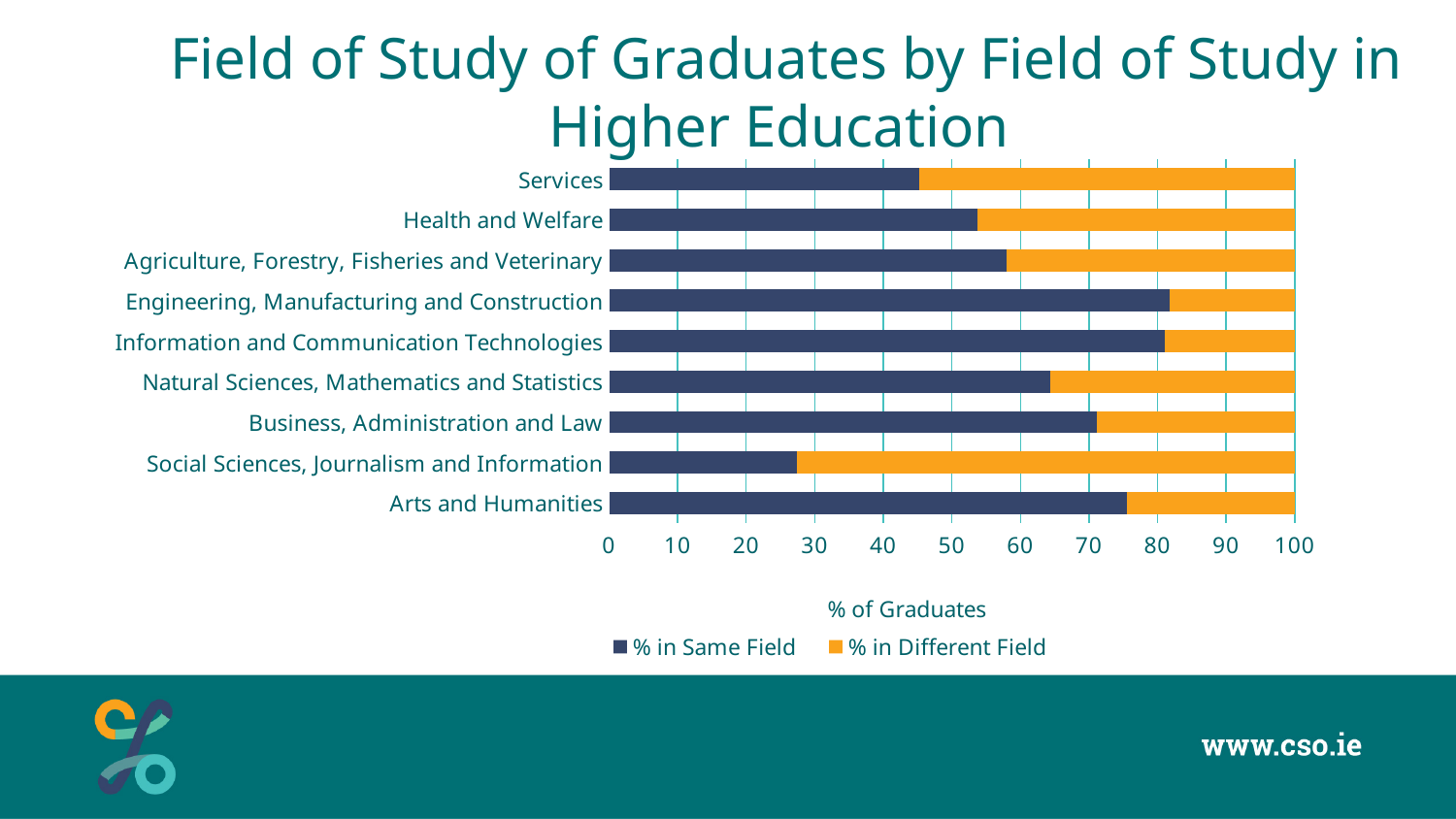
Which has a larger % in Different Field: Services or Arts and Humanities? Services How many series does the legend list? 2 Which field of study has the highest % in Different Field? Social Sciences, Journalism and Information What is the total of the stacked bar for Health and Welfare? 100 What kind of chart is shown on the slide? Stacked bar chart Is the % in Same Field for Engineering, Manufacturing and Construction greater or less than 80? greater Is the % in Same Field for Services greater or less than 50? less Which has a larger % in Same Field: Business, Administration and Law or Health and Welfare? Business, Administration and Law How many fields of study are listed on the chart? 9 What is the label on the horizontal axis? % of Graduates Is the % in Same Field for Social Sciences, Journalism and Information greater or less than 30? less Which field of study has the lowest % in Same Field? Social Sciences, Journalism and Information